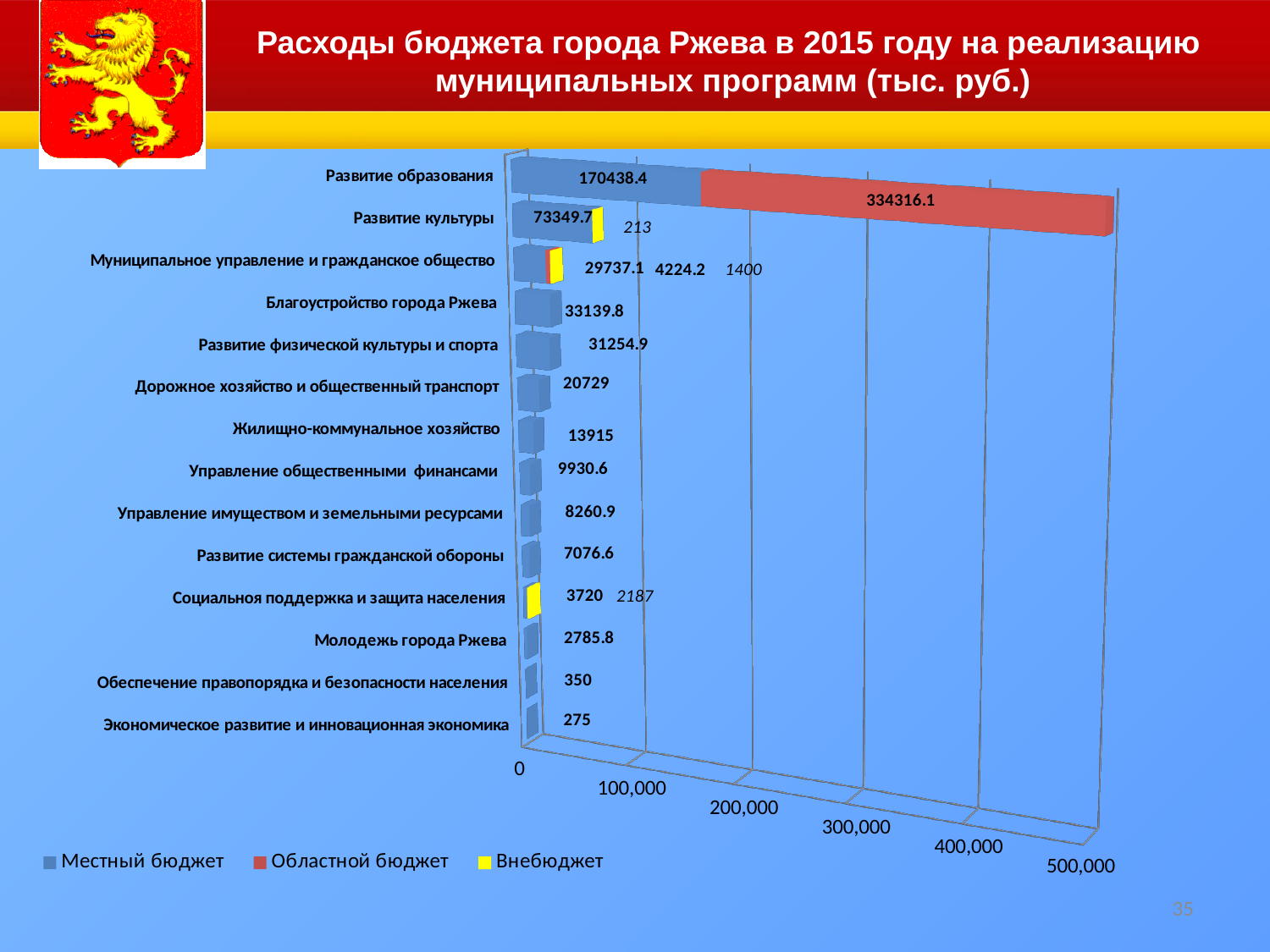
What is the Местный бюджет value for Развитие образования? 170438.4 What is the difference between the Местный бюджет values for Благоустройство города Ржева and Развитие физической культуры и спорта? 1884.9 Which is larger, the Местный бюджет value for Дорожное хозяйство и общественный транспорт or for Жилищно-коммунальное хозяйство? Дорожное хозяйство и общественный транспорт What is the Внебюджет value for Социальноя поддержка и защита населения? 2187 Which category has the lowest Местный бюджет value? Экономическое развитие и инновационная экономика How many series does the legend list? 3 How many categories are shown on the chart? 14 What is the total of the stacked bar for Развитие образования? 504754.5 What kind of chart is shown on the slide? Stacked bar chart Which category has the highest Местный бюджет value? Развитие образования What is the Областной бюджет value for Развитие образования? 334316.1 What is the Областной бюджет value for Муниципальное управление и гражданское общество? 4224.2